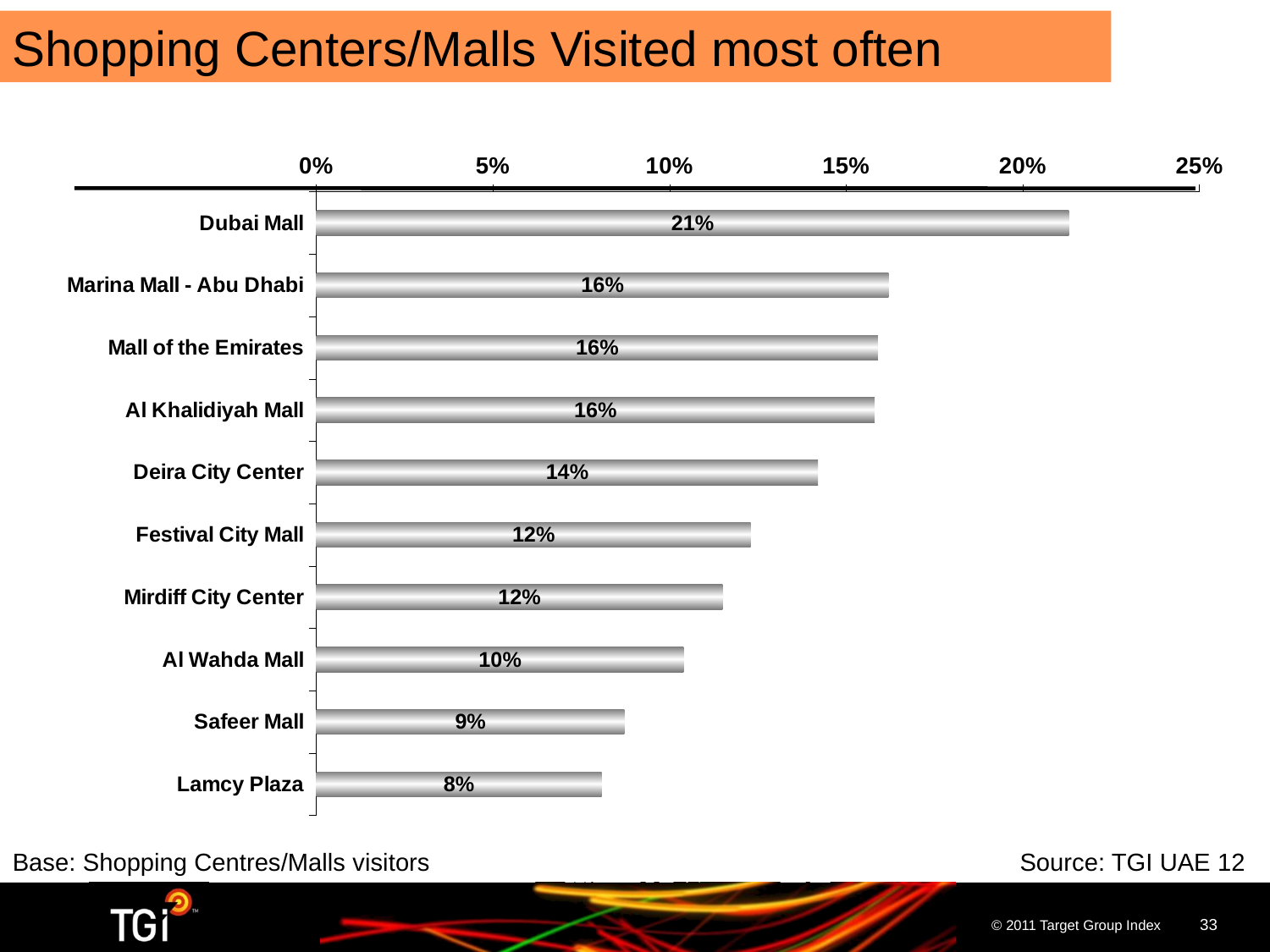
What is the value shown for Lamcy Plaza? 8% What is the title of the slide? Shopping Centers/Malls Visited most often How many shopping centers are shown in the chart? 10 Which has a larger value, Deira City Center or Festival City Mall? Deira City Center What is the value shown for Al Wahda Mall? 10% Which shopping center has the highest value? Dubai Mall Is the value for Dubai Mall greater or less than 20%? greater What is the difference between the values for Dubai Mall and Safeer Mall? 12% What percentage of visitors visit Dubai Mall most often? 21% What is the value shown for Deira City Center? 14% Which shopping center has the lowest value? Lamcy Plaza What kind of chart is shown on the slide? Bar chart